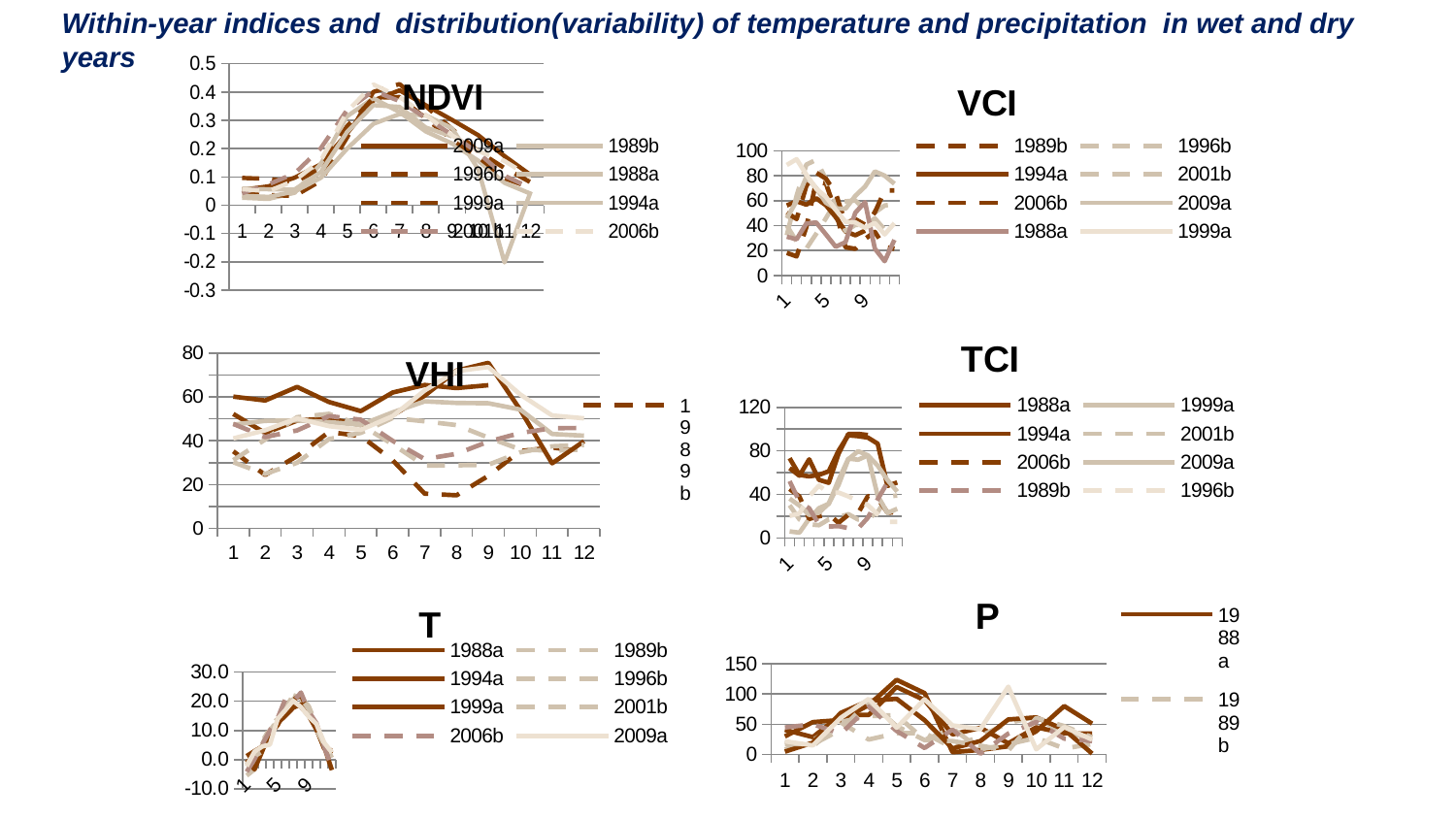
In the NDVI chart, is the highest value reached by any line greater or less than 0.3? greater In the VHI chart, is the highest value reached by any line greater or less than 60? greater In the T chart, is the peak value greater or less than 10.0? greater In the NDVI chart, do the values generally rise or fall from month 1 to month 7? rise How many points are on the x axis of the VHI chart? 12 How many series does the legend of the VCI chart list? 8 What kind of chart is the NDVI chart? line chart How many series does the legend of the T chart list? 8 What is the highest value shown on the y axis of the TCI chart? 120 How many series does the legend of the NDVI chart list? 8